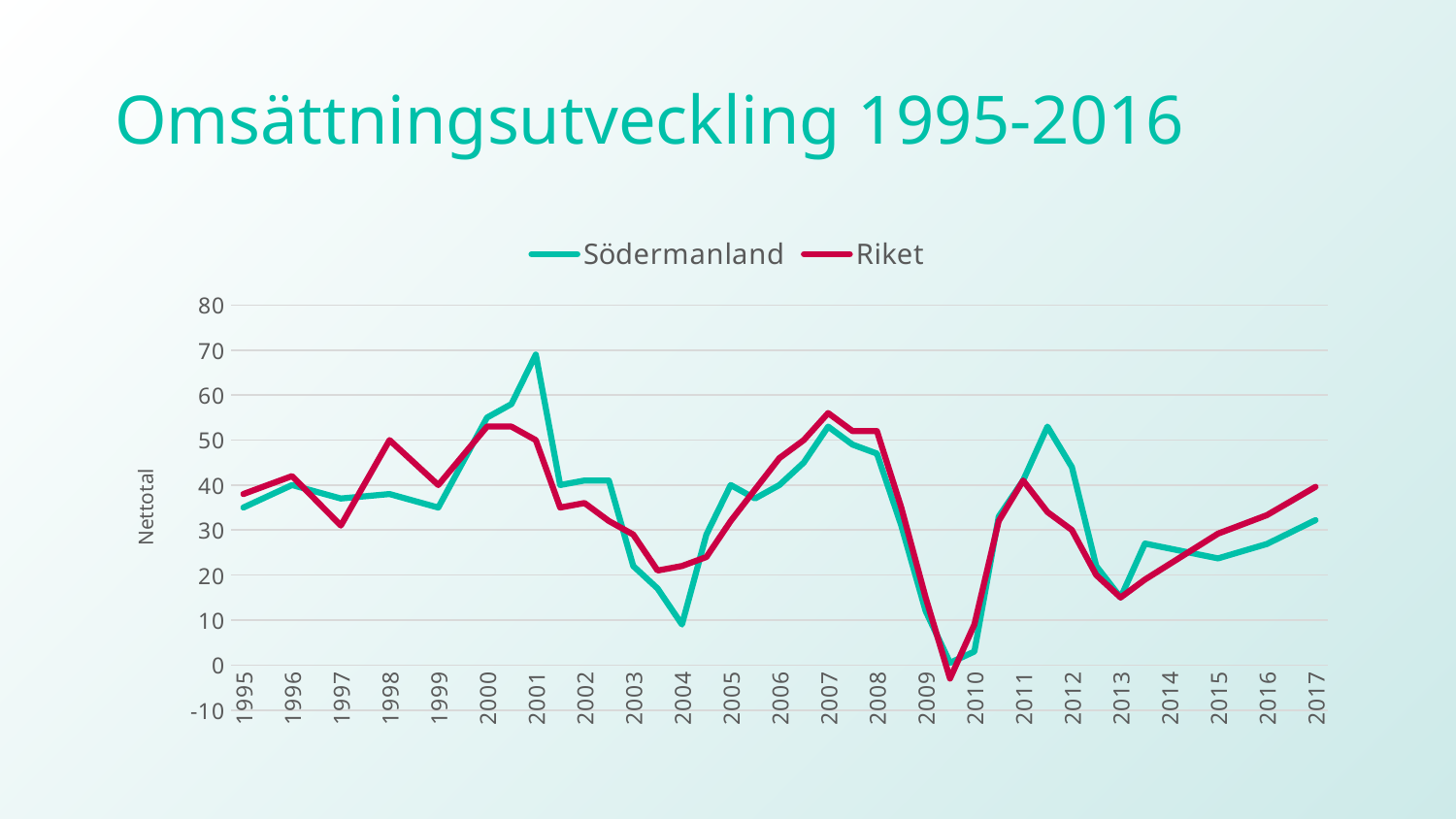
In 2004, which series has the higher value, Södermanland or Riket? Riket Is the value for Riket in 2009 greater or less than 0? less Which two series are shown in the legend? Södermanland and Riket Does the Riket line rise or fall between 2013 and 2017? rise In which year does the Södermanland line reach its highest value? 2001 What kind of chart is shown on the slide? line chart What is the label of the vertical axis? Nettotal How many series does the legend list? 2 Is the value for Södermanland in 2001 greater or less than 60? greater In which year does the Riket line reach its lowest value? 2009 Is the value for Riket in 2013 greater or less than 20? less How many years are labelled on the x axis? 23